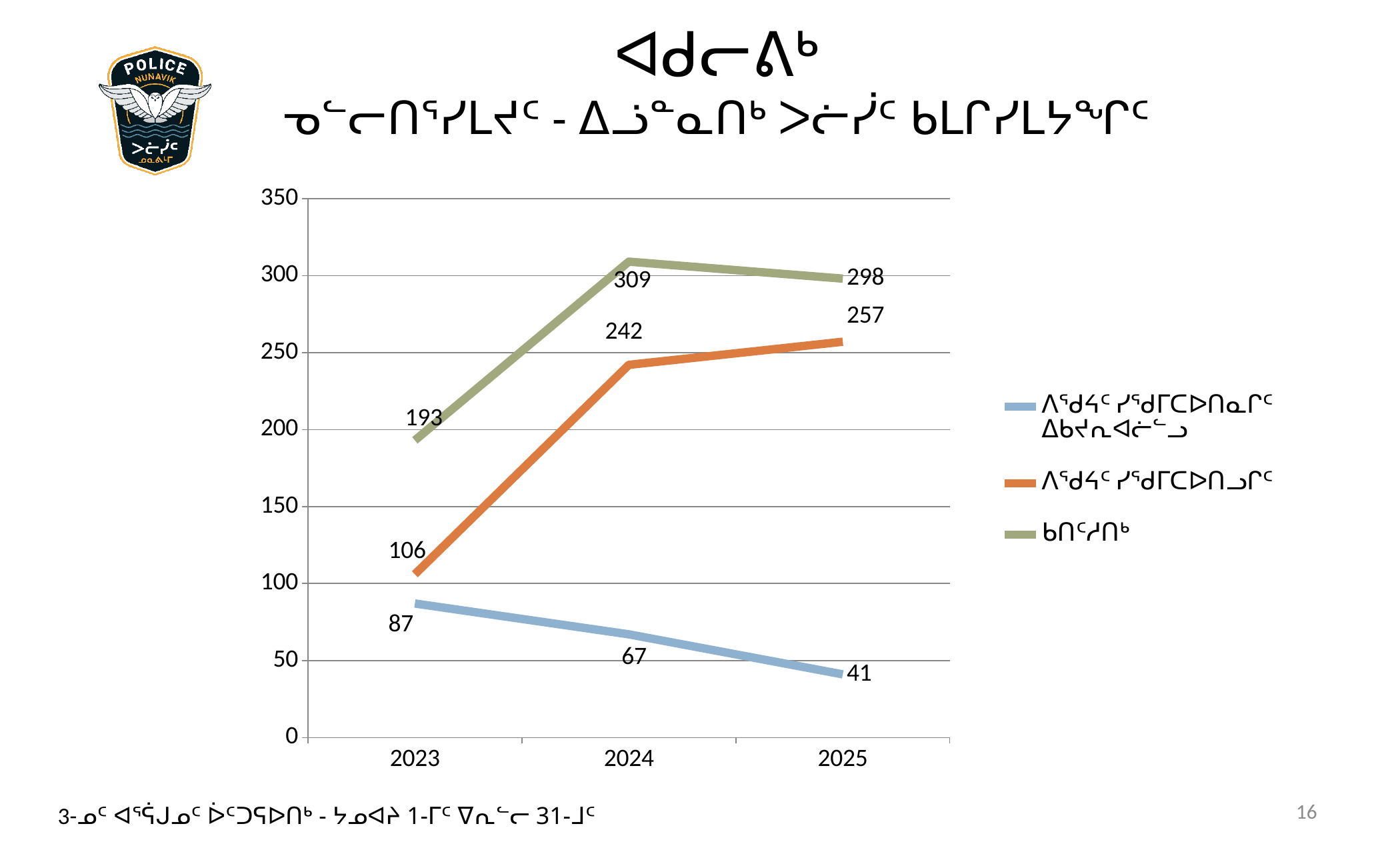
What is the value of the blue line in 2023? 87 In 2025, which is larger: the green line's value or the orange line's value? the green line What is the value of the green line in 2024? 309 Does the blue line rise or fall from 2023 to 2025? fall How many years are plotted along the x axis of the chart? 3 How many series does the chart's legend list? 3 What kind of chart is shown on the slide? line chart In which year is the blue line at its lowest value? 2025 By how much did the orange line increase from 2023 to 2024? 136 What is the value of the orange line in 2025? 257 In which year does the green line reach its highest value? 2024 What is the difference between the green line's 2024 value and its 2025 value? 11